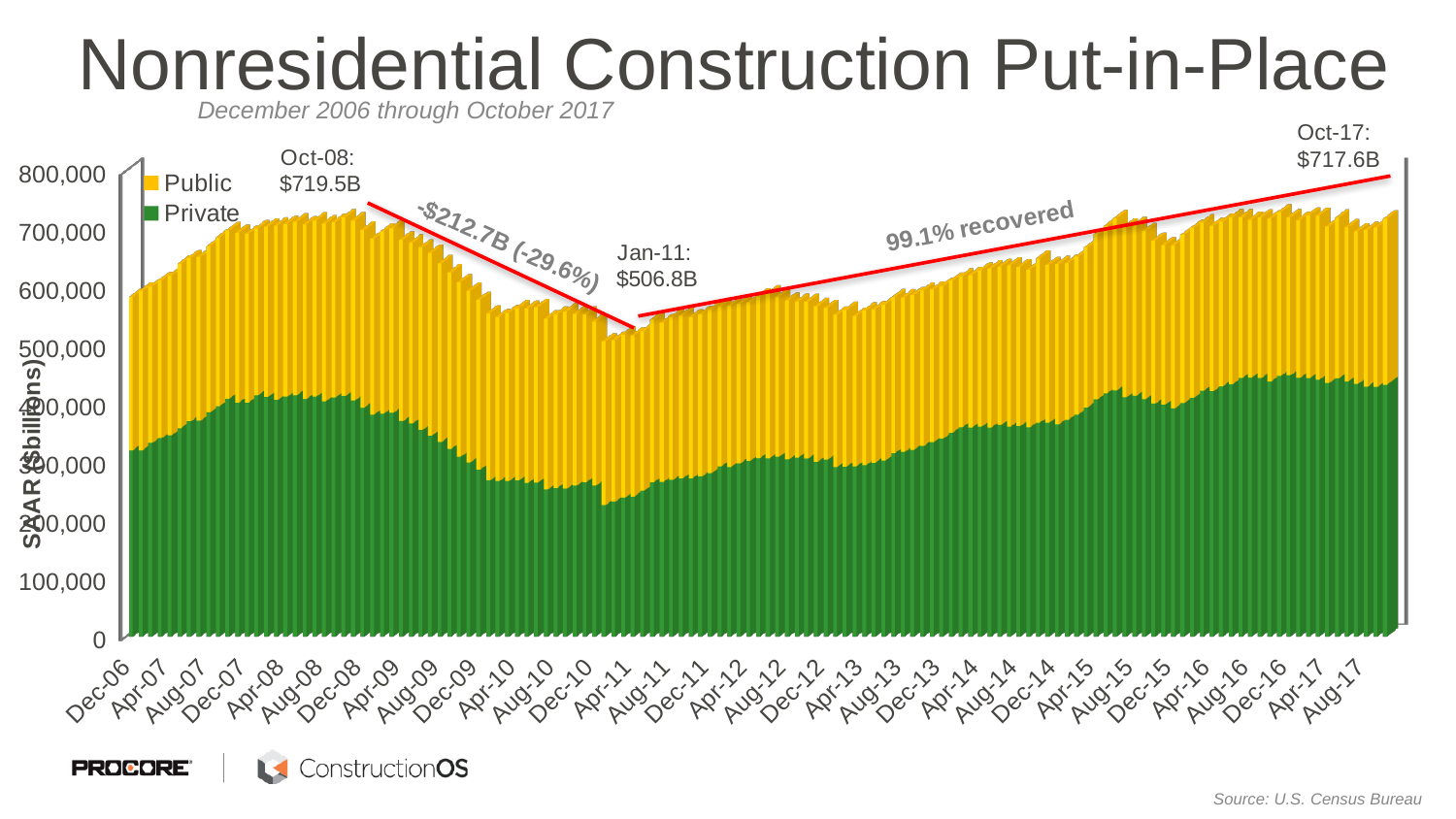
Is the total value for Apr-11 greater or less than 600,000? less Is the total value for Dec-06 greater or less than 500,000? greater Do the total values rise or fall from Jan-11 to Oct-17? rise How many series does the legend list? 2 What percentage of the decline is annotated as recovered by Oct-17? 99.1% Which annotated total is larger, Oct-08 or Oct-17? Oct-08 What total value is annotated for Oct-08? $719.5B Which colour represents the Public series in the legend? Yellow By how much did the total decline from Oct-08 to Jan-11, according to the annotation? -$212.7B (-29.6%) What total value is annotated for Oct-17? $717.6B What total value is annotated for Jan-11? $506.8B What kind of chart is shown on the slide? Stacked bar chart